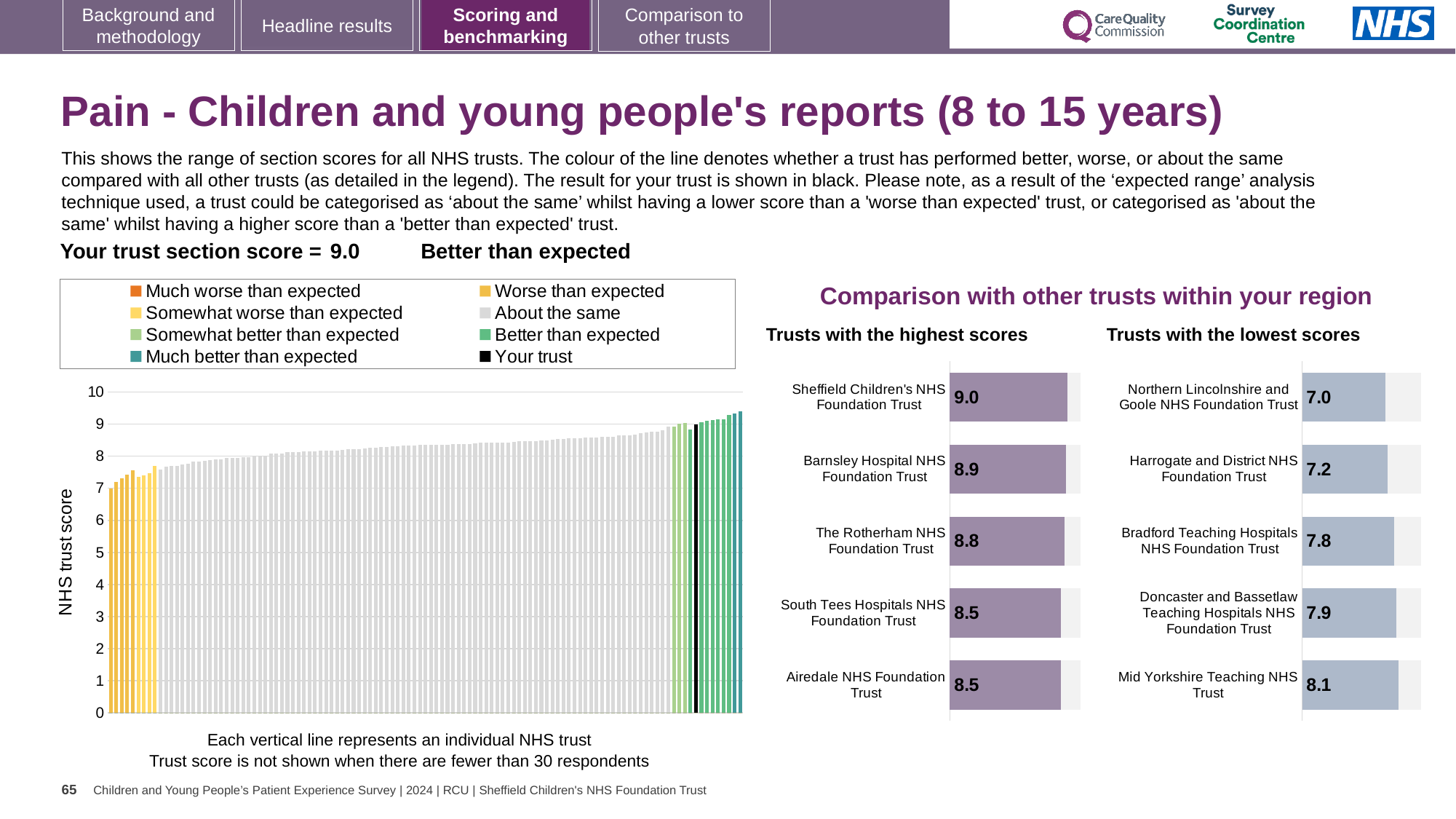
In the 'Trusts with the highest scores' chart, which trust has the highest score? Sheffield Children's NHS Foundation Trust How many trusts are shown in the 'Trusts with the highest scores' chart? 5 In the 'Trusts with the highest scores' chart, what is the difference between the scores of Barnsley Hospital NHS Foundation Trust and The Rotherham NHS Foundation Trust? 0.1 In the 'NHS trust score' chart, do the trust scores rise or fall from left to right? rise In the 'Trusts with the lowest scores' chart, what is the difference between the scores of Mid Yorkshire Teaching NHS Trust and Northern Lincolnshire and Goole NHS Foundation Trust? 1.1 How many entries does the legend above the 'NHS trust score' chart list? 8 In the 'Trusts with the lowest scores' chart, what is the score for Northern Lincolnshire and Goole NHS Foundation Trust? 7.0 What kind of chart is the 'NHS trust score' chart on the left of the slide? bar chart In the 'Trusts with the lowest scores' chart, which has the larger score: Harrogate and District NHS Foundation Trust or Bradford Teaching Hospitals NHS Foundation Trust? Bradford Teaching Hospitals NHS Foundation Trust In the 'Trusts with the highest scores' chart, what is the score for Sheffield Children's NHS Foundation Trust? 9.0 In the 'Trusts with the lowest scores' chart, which trust has the lowest score? Northern Lincolnshire and Goole NHS Foundation Trust In the 'NHS trust score' chart, is the value for the black 'Your trust' line greater or less than 8? greater